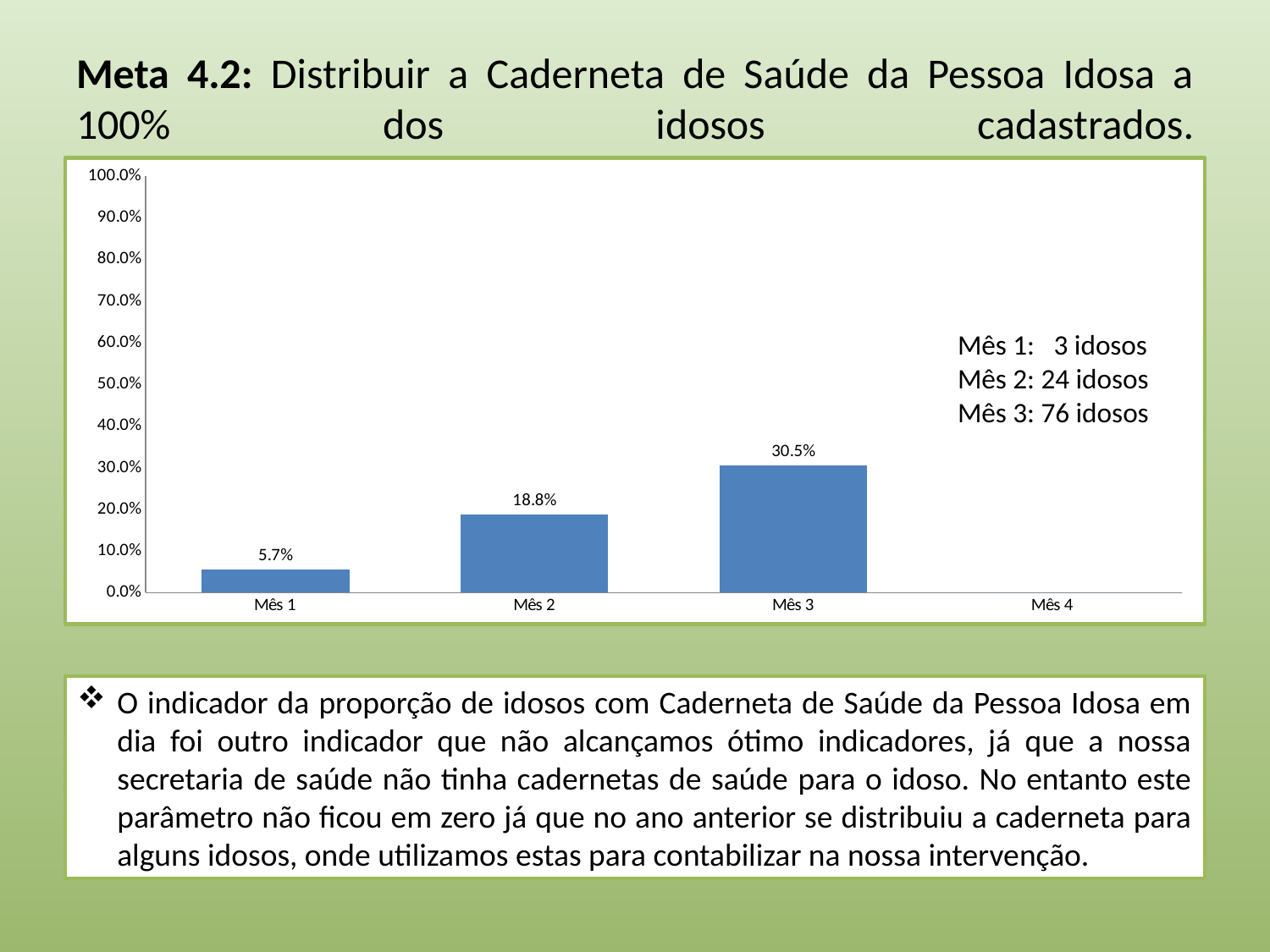
What is the difference between the values for Mês 2 and Mês 1? 13.1% What is the difference between the values for Mês 3 and Mês 2? 11.7% Do the values rise or fall from Mês 1 to Mês 3? rise What is the value for Mês 2? 18.8% What is the value for Mês 3? 30.5% Which month has the highest value? Mês 3 How many month categories are shown on the x axis? 4 Among the months with a bar shown, which has the lowest value? Mês 1 Which is larger, the value for Mês 2 or the value for Mês 1? Mês 2 What kind of chart is shown on the slide? bar chart Is the value for Mês 3 greater or less than 40.0%? less What is the value for Mês 1? 5.7%